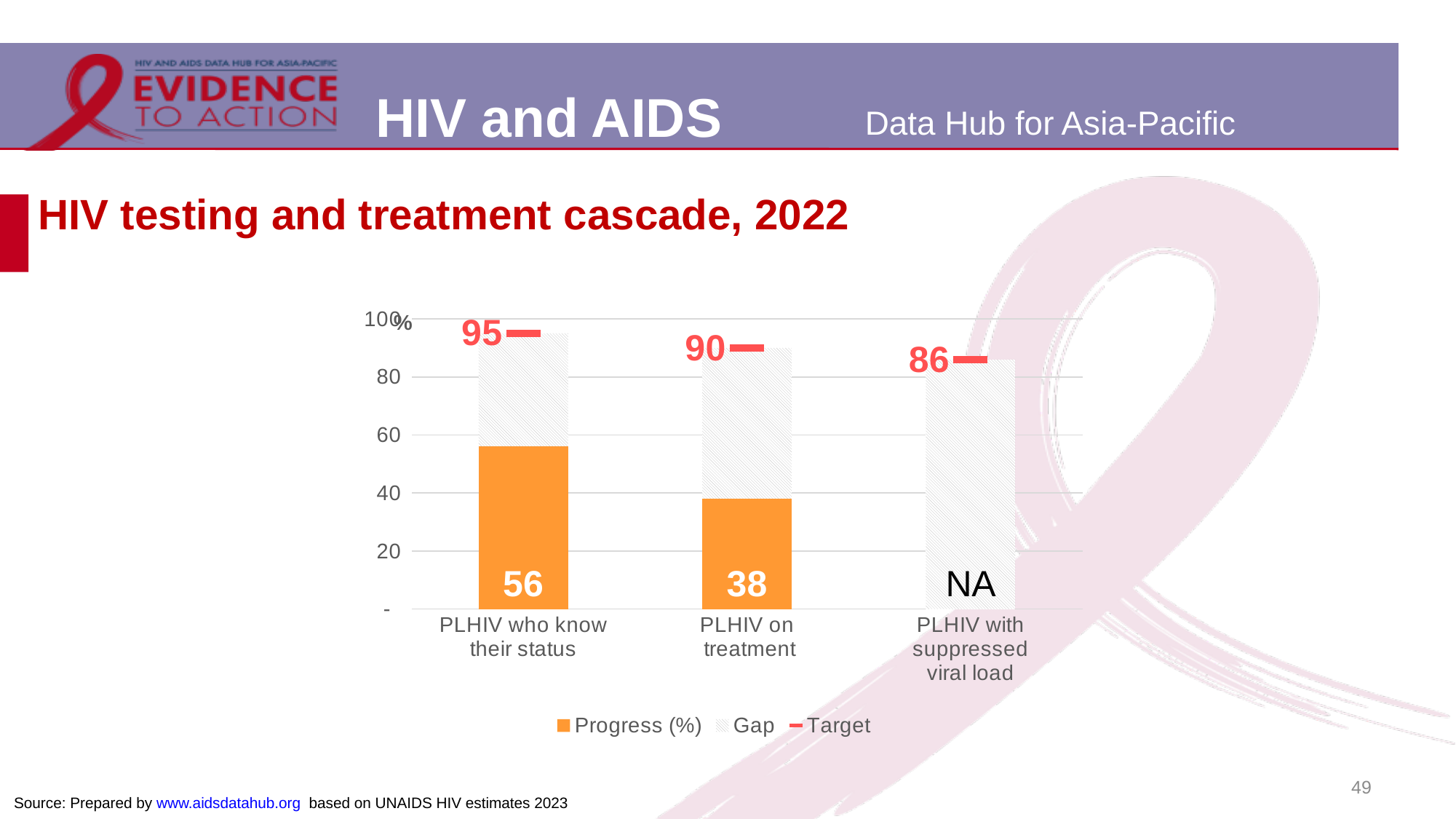
Which is larger, the Progress (%) for PLHIV who know their status or for PLHIV on treatment? PLHIV who know their status How many categories are shown on the x axis? 3 What is the Progress (%) value for PLHIV on treatment? 38 What is the Target value for PLHIV on treatment? 90 How many series does the legend list? 3 What is the Progress (%) value for PLHIV who know their status? 56 What is the Progress (%) value shown for PLHIV with suppressed viral load? NA Which category has the highest Target value? PLHIV who know their status What is the Target value for PLHIV with suppressed viral load? 86 What kind of chart is shown on the slide? Bar chart What is the Target value for PLHIV who know their status? 95 What is the difference between the Progress (%) values for PLHIV who know their status and PLHIV on treatment? 18